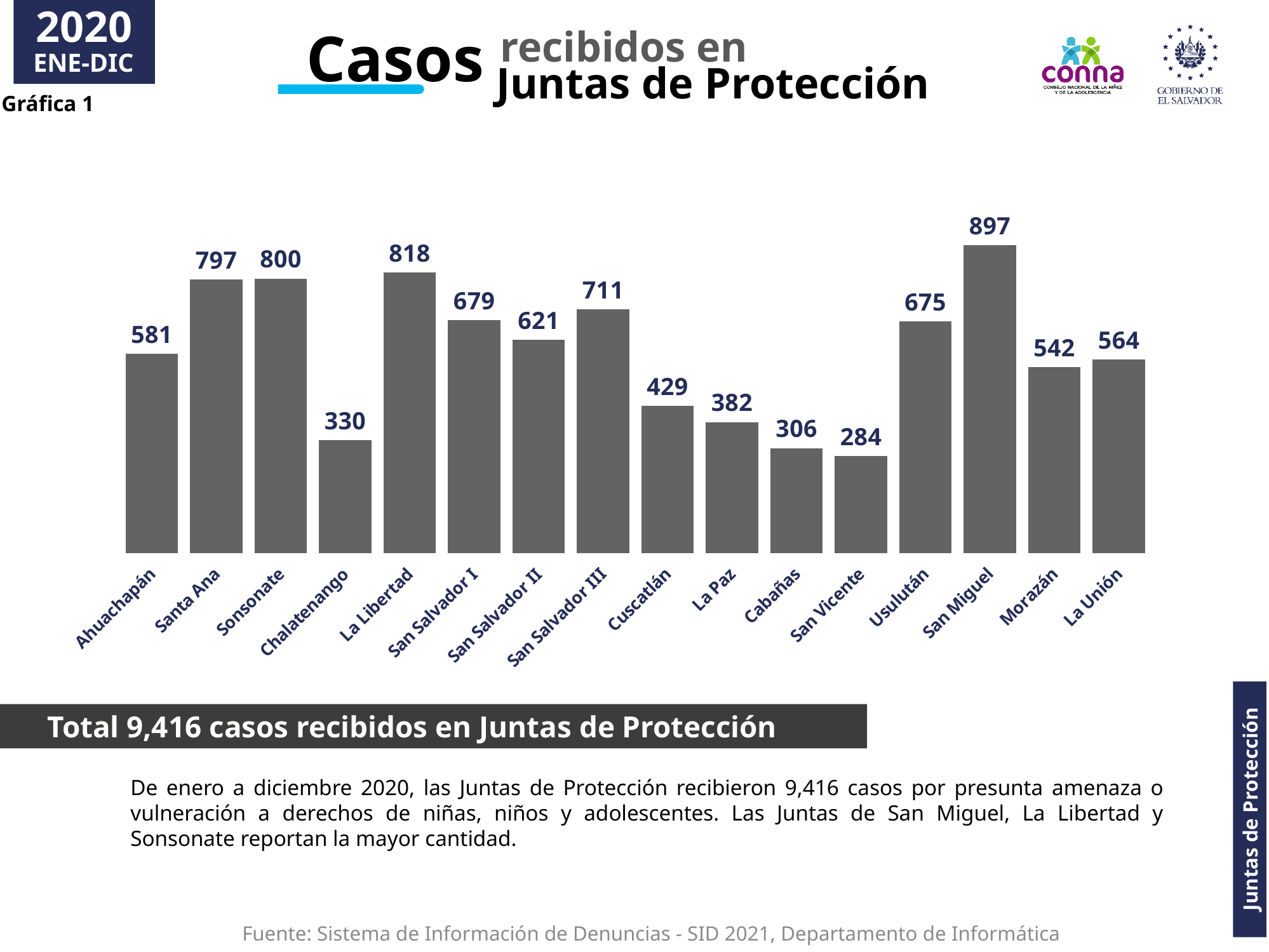
What is the value shown for San Salvador III? 711 What is the value shown for Chalatenango? 330 What kind of chart is shown on the slide? Bar chart What total number of cases received in Juntas de Protección is stated on the slide? 9,416 What is the difference between the cases for San Miguel and San Vicente? 613 Which Junta de Protección received the highest number of cases? San Miguel Which received more cases, Usulután or San Salvador I? San Salvador I How many Juntas de Protección (categories) are shown on the chart? 16 How many cases were received by the Junta de Protección in San Miguel? 897 Which Junta de Protección received the lowest number of cases? San Vicente Which received more cases, Morazán or La Unión? La Unión What is the difference between the cases for La Libertad and Sonsonate? 18